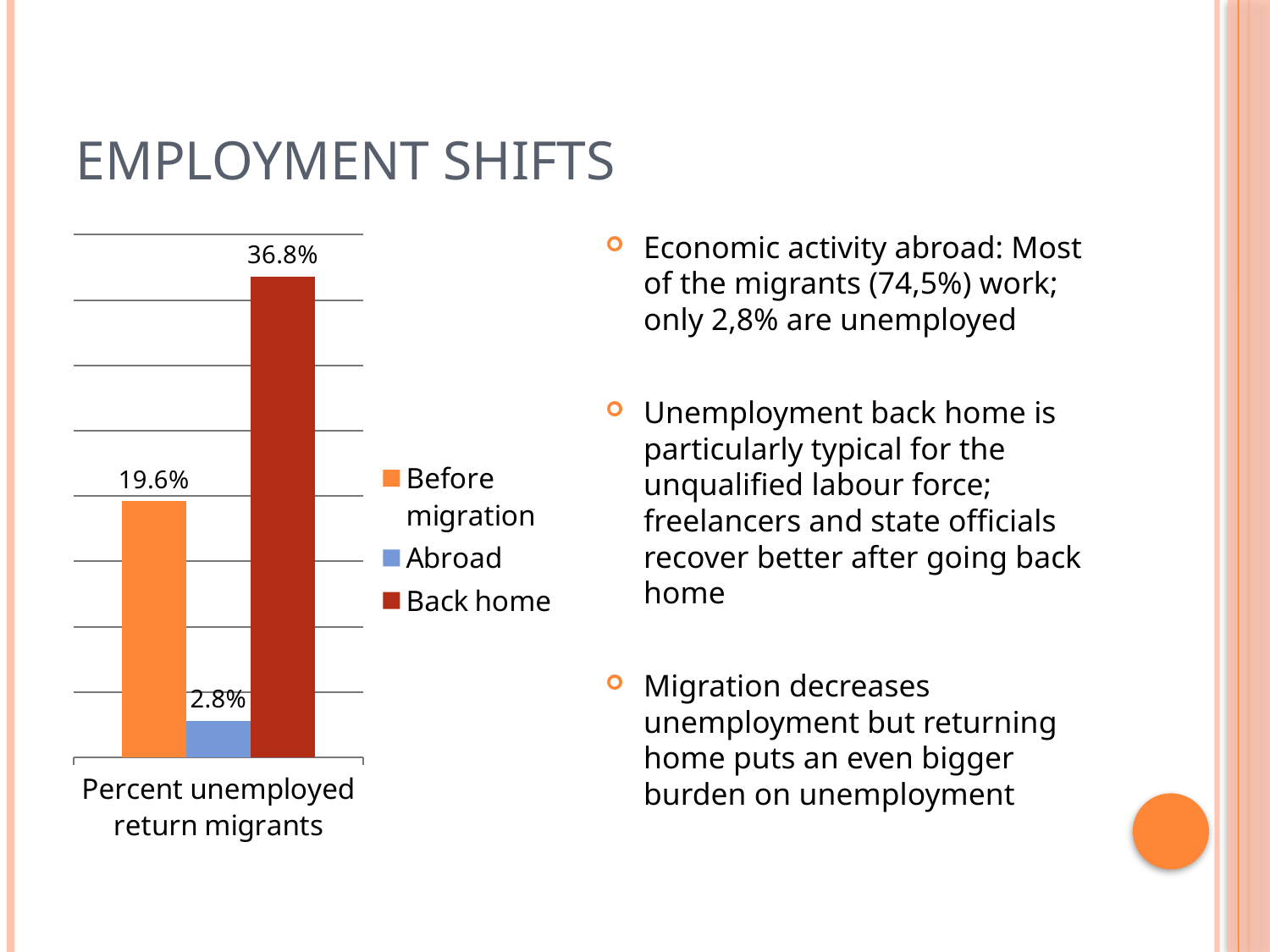
Which is larger, the value for Before migration or the value for Abroad? Before migration What is the value for Back home in the chart? 36.8% What is the category label shown below the bars? Percent unemployed return migrants What is the difference between the Before migration and Abroad values? 16.8% What kind of chart is shown on the slide? Bar chart What is the value for Before migration in the chart? 19.6% Which series has the lowest value in the chart? Abroad What colour is the Back home bar in the chart? Dark red What is the difference between the Back home and Before migration values? 17.2% How many series does the legend list? 3 Which series has the highest value in the chart? Back home What is the value for Abroad in the chart? 2.8%